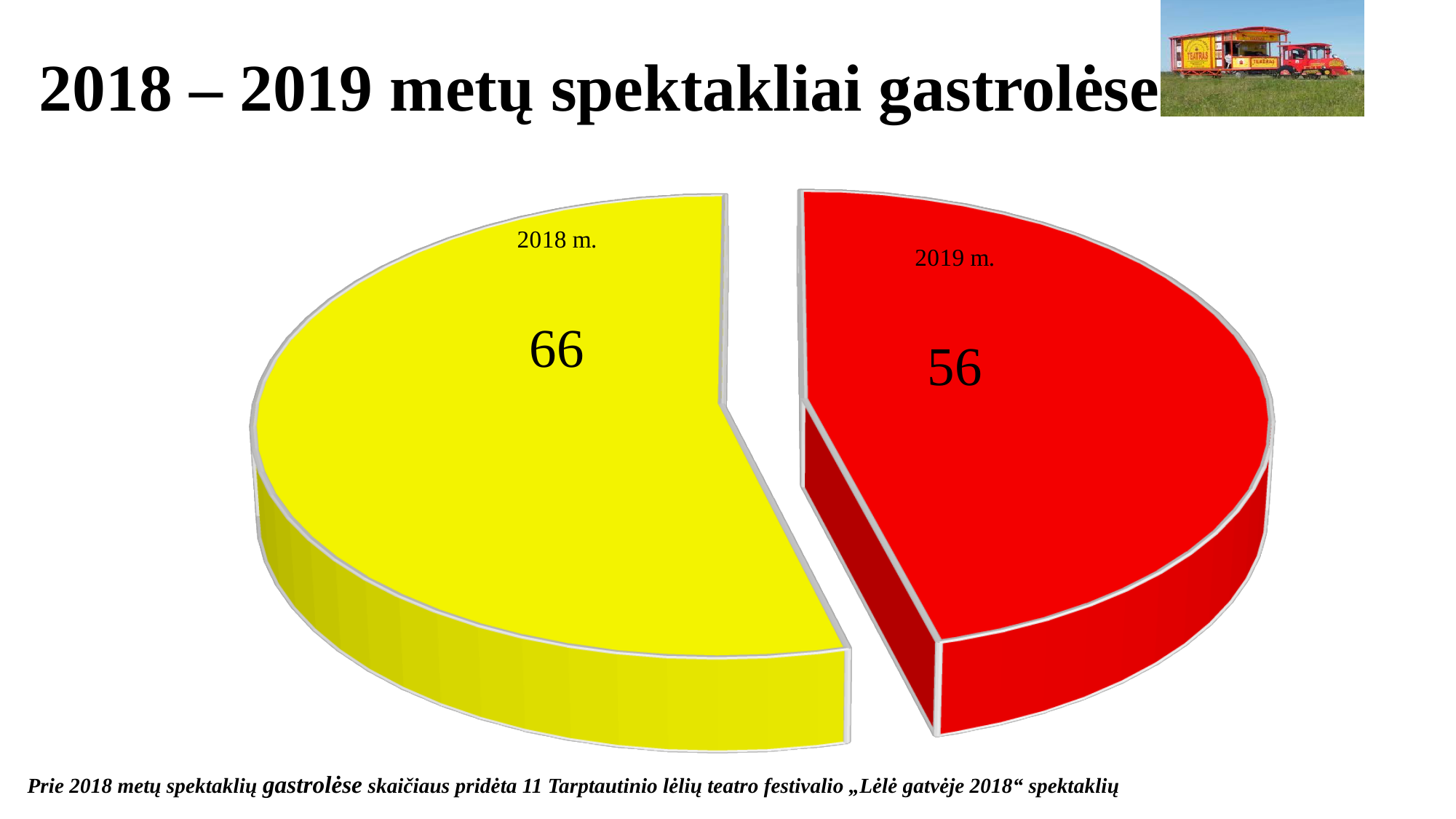
What is the value for 2019 m.? 56 What colour is the slice for 2018 m.? yellow What kind of chart is shown on the slide? pie chart Is the value for 2018 m. larger or smaller than the value for 2019 m.? larger What is the difference between the values for 2018 m. and 2019 m.? 10 What colour is the slice for 2019 m.? red How many slices does the pie chart have? 2 What is the total of the two slices? 122 What is the value for 2018 m.? 66 Which year has the smaller slice? 2019 m. Which year has the larger slice? 2018 m.